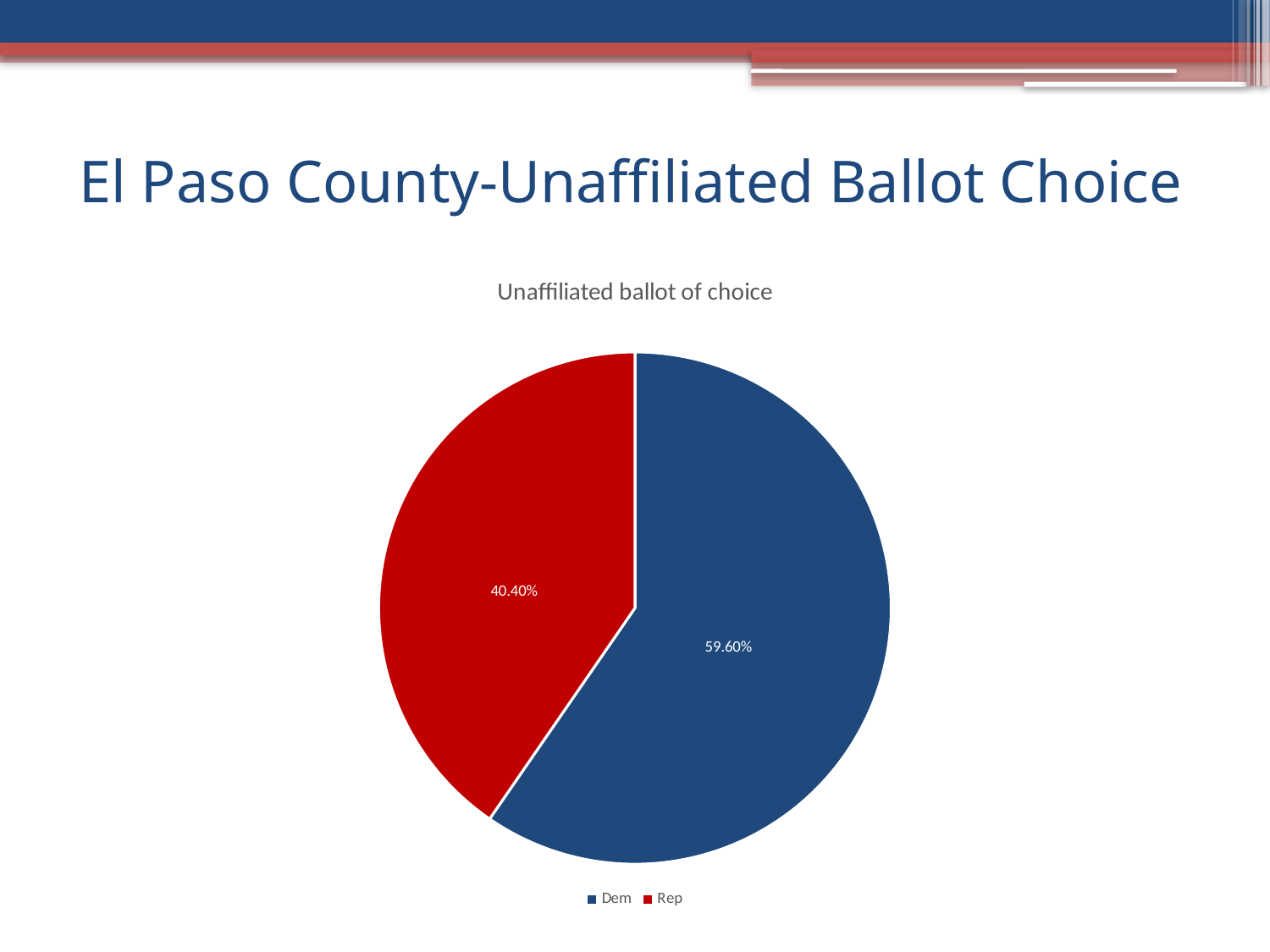
Is the Dem share greater or less than 50%? greater Which category has the smallest slice of the pie? Rep What colour is the Rep slice? red What is the title of the chart? Unaffiliated ballot of choice What share of the pie does Rep have? 40.40% Which is larger, the Dem slice or the Rep slice? Dem How many entries does the legend list? 2 How many slices does the pie chart have? 2 Which category has the largest slice of the pie? Dem What is the difference between the Dem share and the Rep share? 19.20% What kind of chart is shown on the slide? pie chart What share of the pie does Dem have? 59.60%